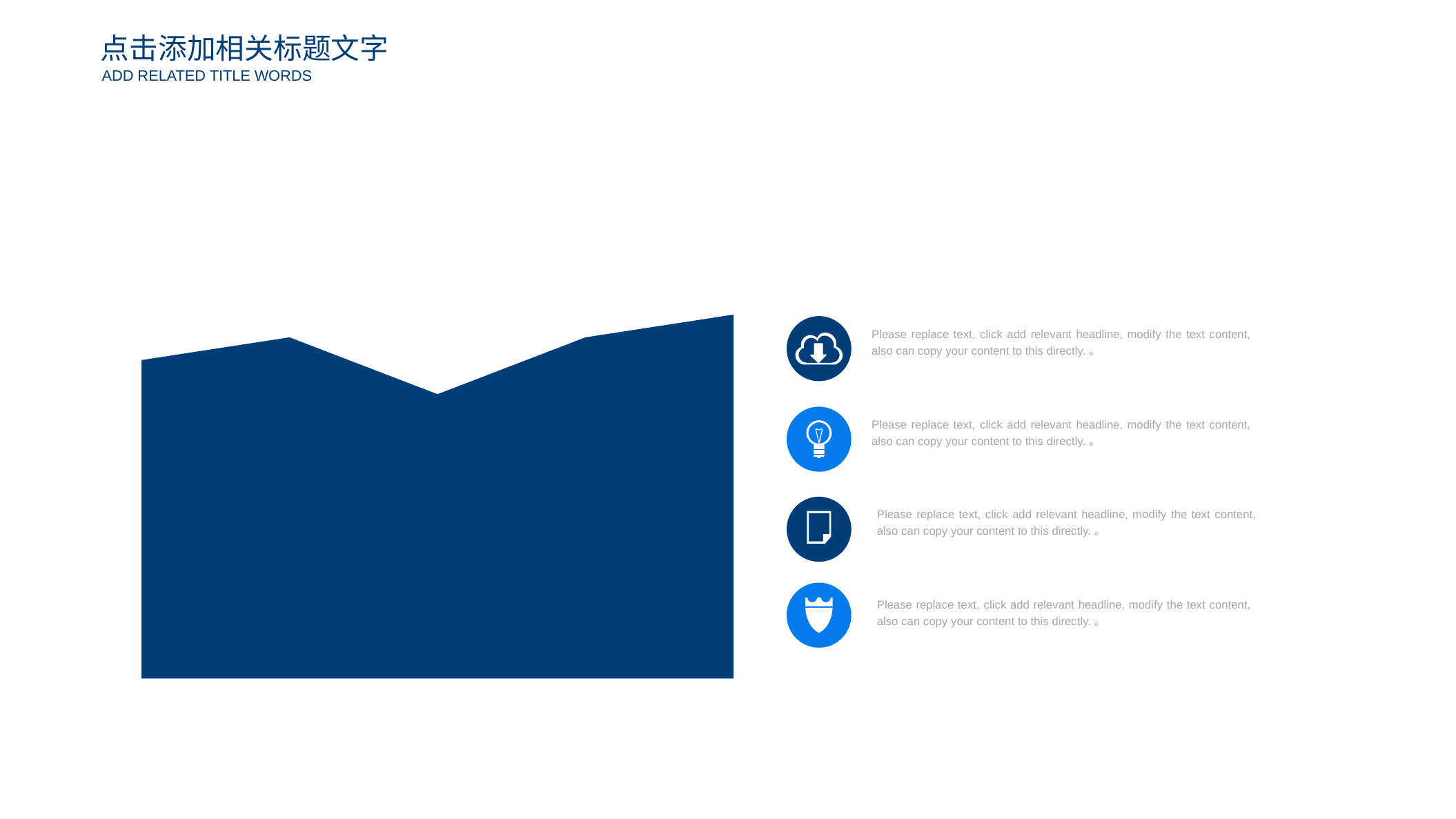
Does the area chart rise or fall between its second and third points? fall Which data point of the area chart is the lowest? the middle (third) point Does the area chart rise or fall between its third and fifth points? rise What colour is the filled area of the chart? dark blue How many data points (vertices) does the area chart's top edge have? 5 Which data point of the area chart is the highest? the rightmost (last) point What kind of chart is shown on the left of the slide? area chart Is the last point of the area chart higher or lower than the first point? higher Does the area chart display a legend? No